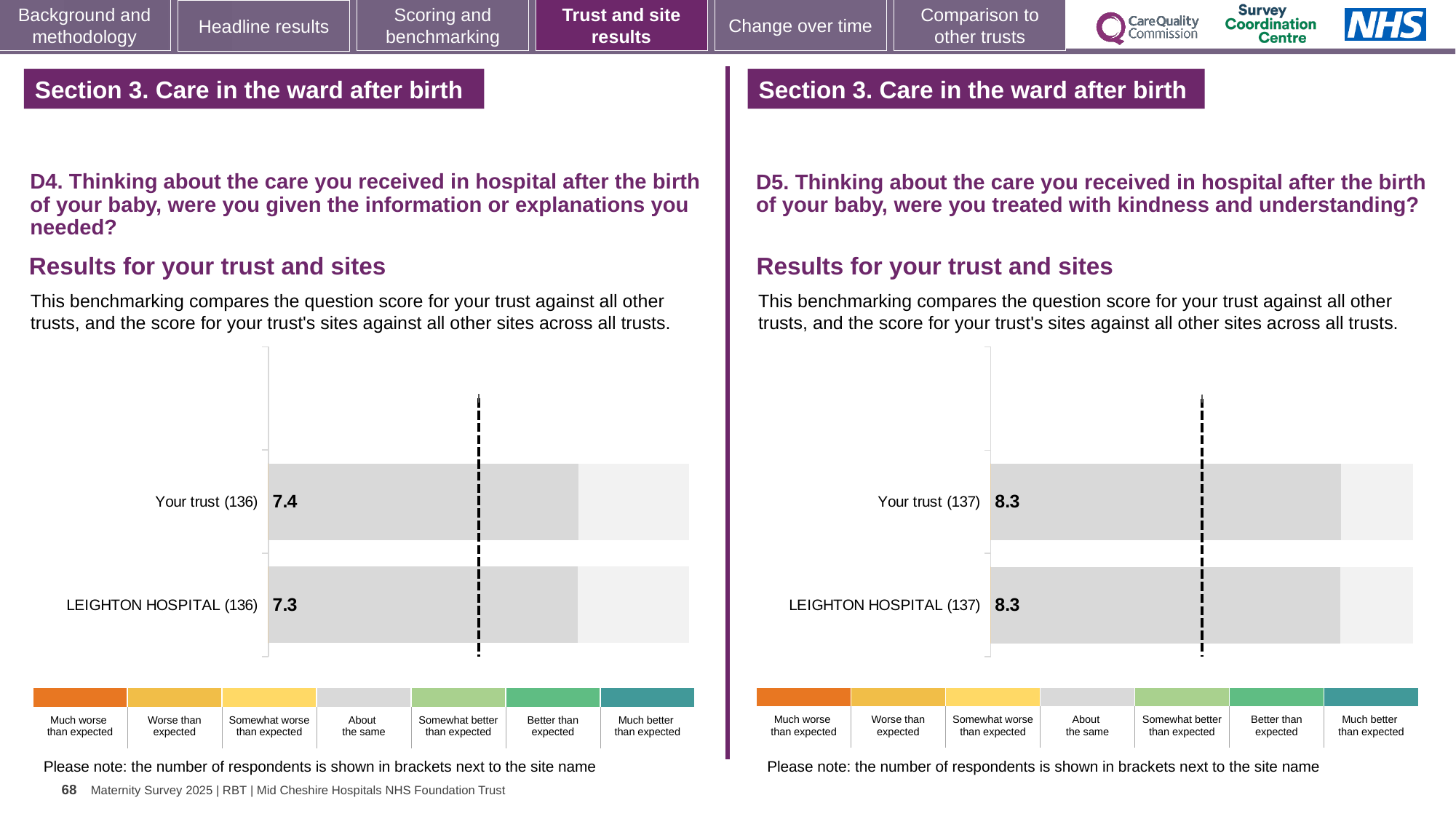
How many bars are plotted in the D5 chart on the right? 2 In the D4 chart on the left, what is the score for Your trust? 7.4 In the D5 chart on the right, what is the difference between the score for Your trust and the score for LEIGHTON HOSPITAL? 0 In the D4 chart on the left, how many respondents are shown in brackets next to Your trust? 136 In the D5 chart on the right, what is the score for Your trust? 8.3 In the D4 chart on the left, what is the difference between the score for Your trust and the score for LEIGHTON HOSPITAL? 0.1 In the D4 chart on the left, what is the score for LEIGHTON HOSPITAL? 7.3 In the D5 chart on the right, what is the score for LEIGHTON HOSPITAL? 8.3 What type of chart is used for the D4 results on the left? Bar chart In the D5 chart on the right, how many respondents are shown in brackets next to LEIGHTON HOSPITAL? 137 How many bars are plotted in the D4 chart on the left? 2 In the D4 chart on the left, which has the higher score, Your trust or LEIGHTON HOSPITAL? Your trust